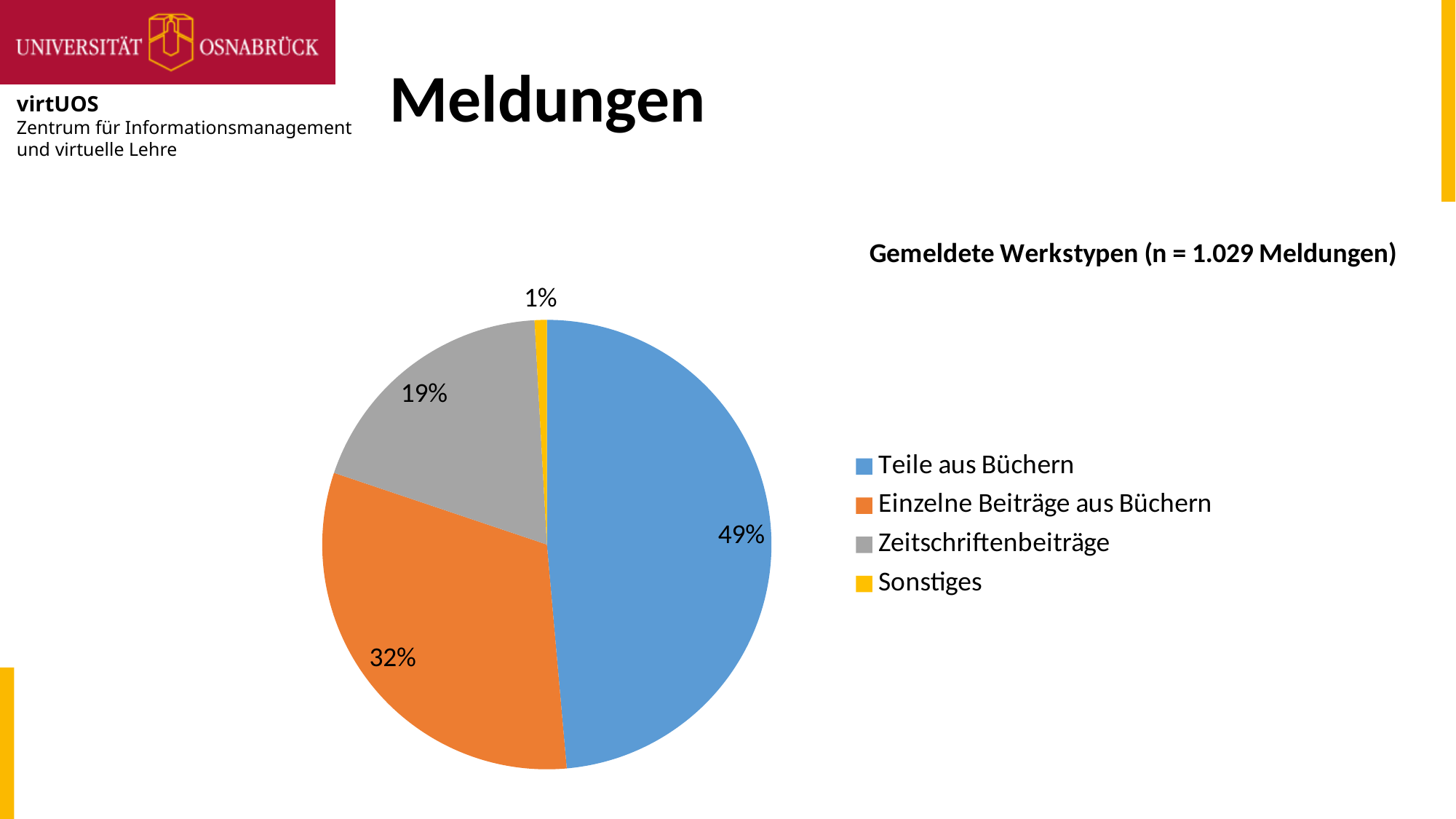
What share of the pie does "Sonstiges" have? 1% What kind of chart is shown on the slide? pie chart Which category has the smallest slice of the pie? Sonstiges Which is larger, the share for "Zeitschriftenbeiträge" or the share for "Einzelne Beiträge aus Büchern"? Einzelne Beiträge aus Büchern How many categories does the pie chart show? 4 What is the title of the chart? Gemeldete Werkstypen (n = 1.029 Meldungen) Which colour represents "Zeitschriftenbeiträge" in the legend? grey What share of the pie does "Teile aus Büchern" have? 49% What share of the pie does "Einzelne Beiträge aus Büchern" have? 32% What is the difference in percentage points between "Teile aus Büchern" and "Einzelne Beiträge aus Büchern"? 17 percentage points Which category has the largest slice of the pie? Teile aus Büchern